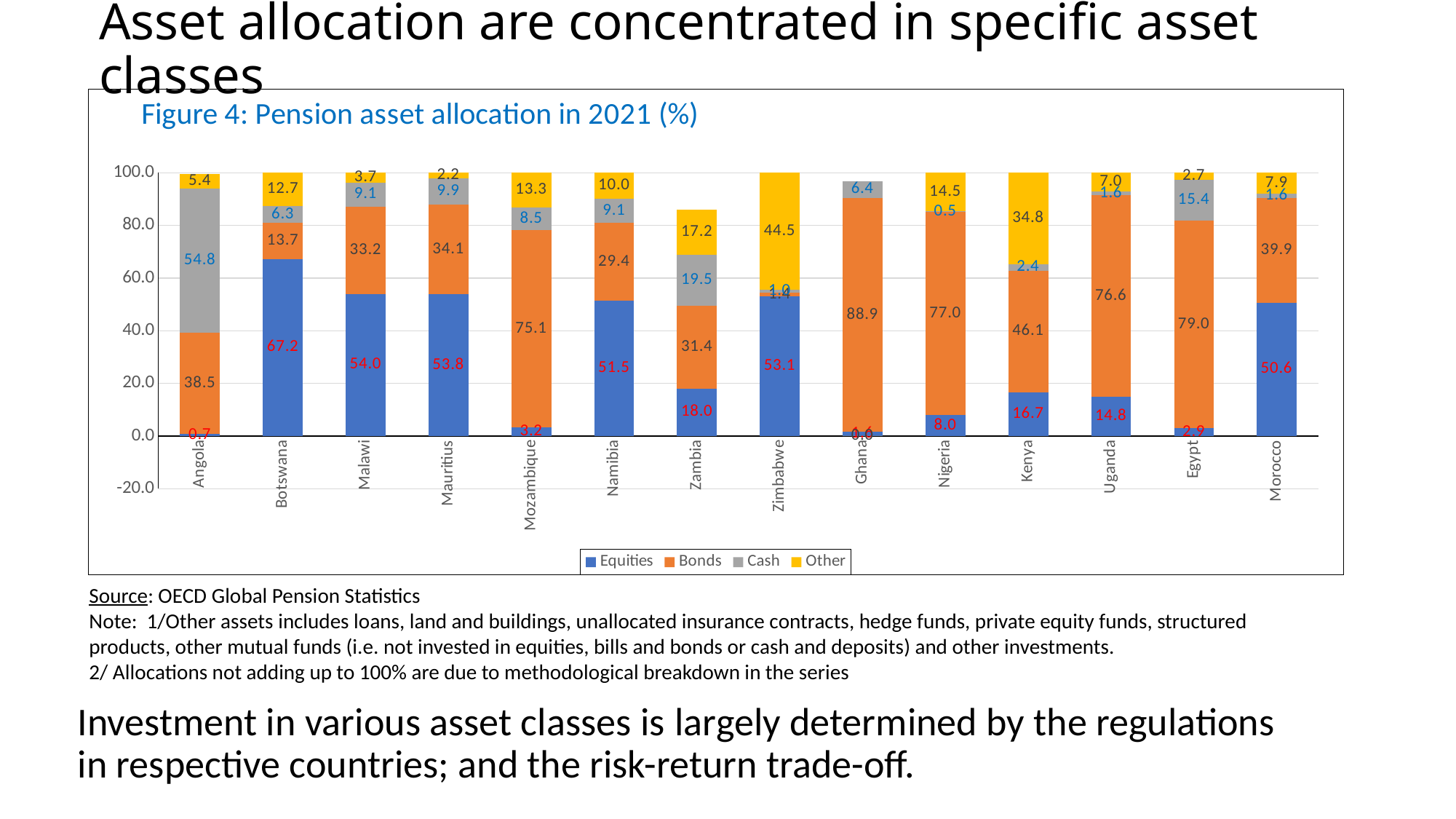
What is the Other value for Kenya? 34.8 What is the Equities value for Botswana? 67.2 Which country has the highest Equities value? Botswana How many countries are shown on the x axis? 14 How many series does the legend list? 4 Which country has the highest Cash value? Angola Which country has the highest Bonds value? Ghana What is the Bonds value for Mozambique? 75.1 What kind of chart is shown? Stacked bar chart What is the Cash value for Angola? 54.8 Which has a larger Bonds value, Egypt or Mozambique? Egypt What is the difference between the Equities values for Botswana and Malawi? 13.2